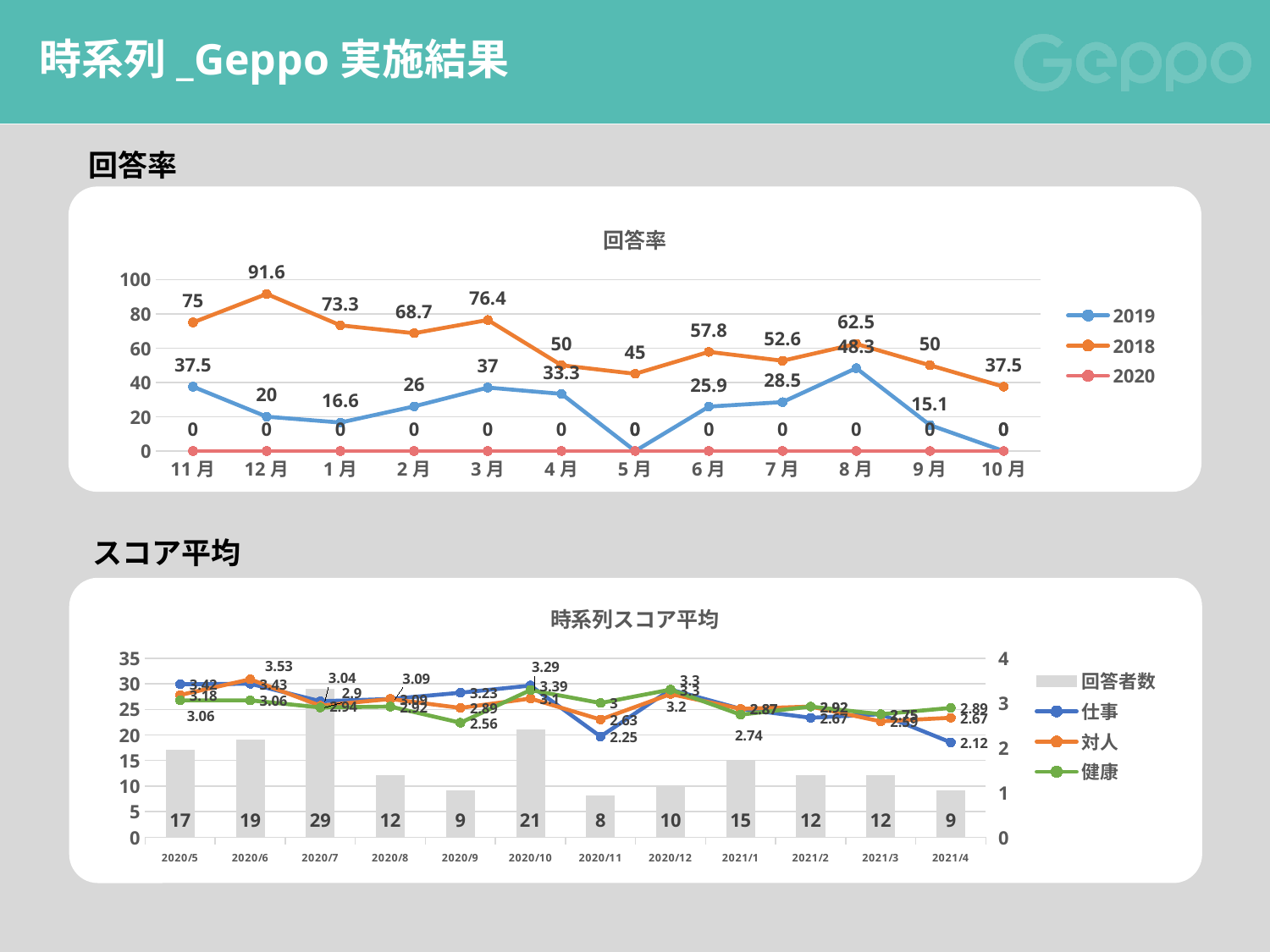
How many months are shown on the x axis of the top chart (回答率)? 12 In the top chart (回答率), in which month is the 2018 series highest? 12月 In the top chart (回答率), what is the difference between the 2018 and 2019 values in 11月? 37.5 How many series does the legend of the top chart (回答率) list? 3 In the bottom chart (時系列スコア平均), what is the 仕事 value for 2021/4? 2.12 In the top chart (回答率), what is the value for 2018 in 12月? 91.6 In the top chart (回答率), which is larger in 3月: the 2018 value or the 2019 value? 2018 In the top chart (回答率), what is the value for 2019 in 8月? 48.3 In the bottom chart (時系列スコア平均), which period has the lowest 回答者数? 2020/11 In the bottom chart (時系列スコア平均), what is the 回答者数 value for 2020/7? 29 How many entries does the legend of the bottom chart (時系列スコア平均) list? 4 What kind of chart is the top chart titled 回答率? line chart